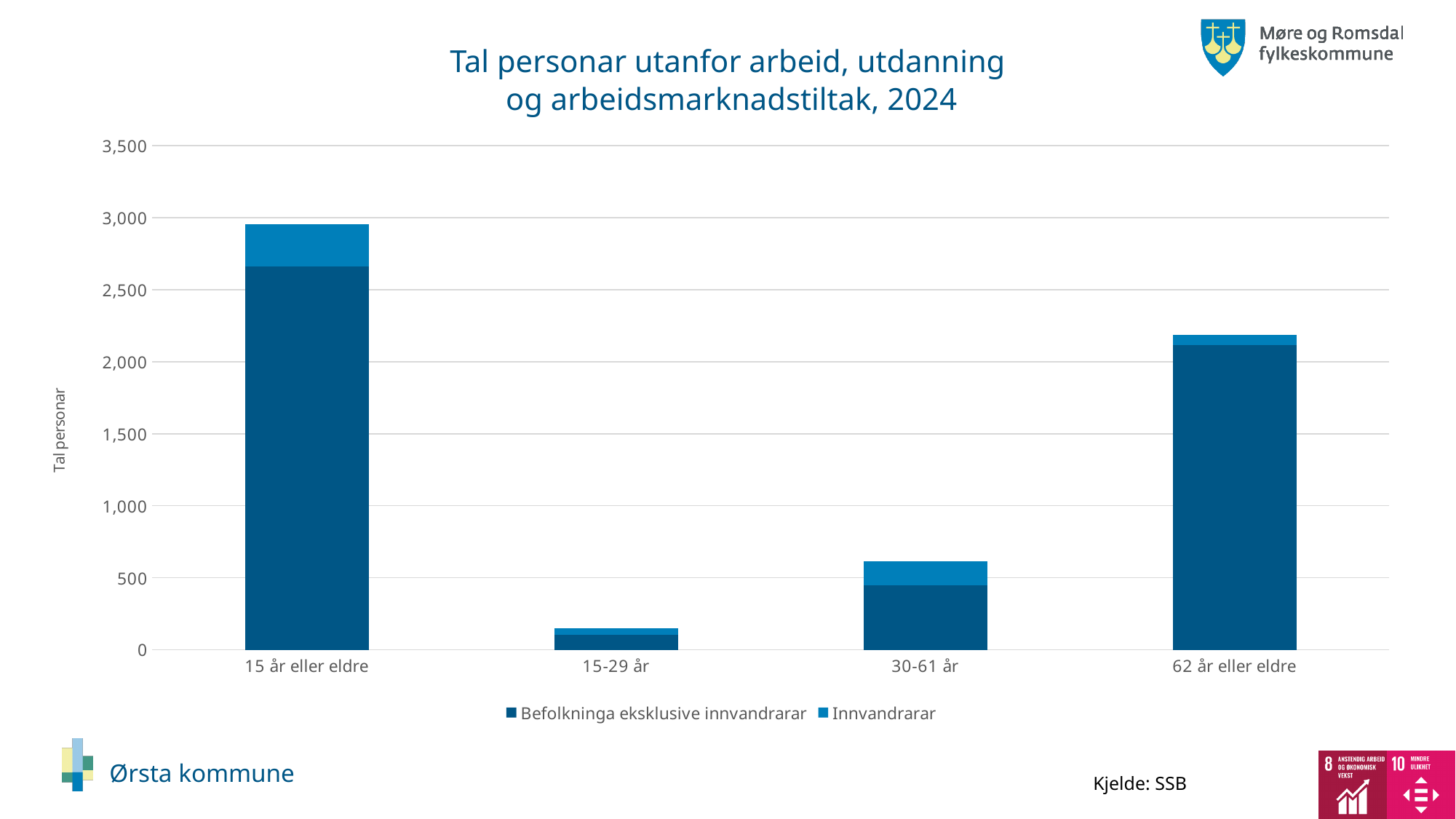
Is the total bar for 62 år eller eldre greater or less than 2,000? greater Is the total bar for 30-61 år greater or less than 500? greater Which category has the shortest total bar? 15-29 år What kind of chart is shown on the slide? Stacked bar chart Is the total bar for 15-29 år greater or less than 500? less How many age categories are shown on the x axis? 4 Which category has the tallest total bar? 15 år eller eldre What is the title of the chart? Tal personar utanfor arbeid, utdanning og arbeidsmarknadstiltak, 2024 How many series does the legend list? 2 Which total bar is taller: 62 år eller eldre or 30-61 år? 62 år eller eldre